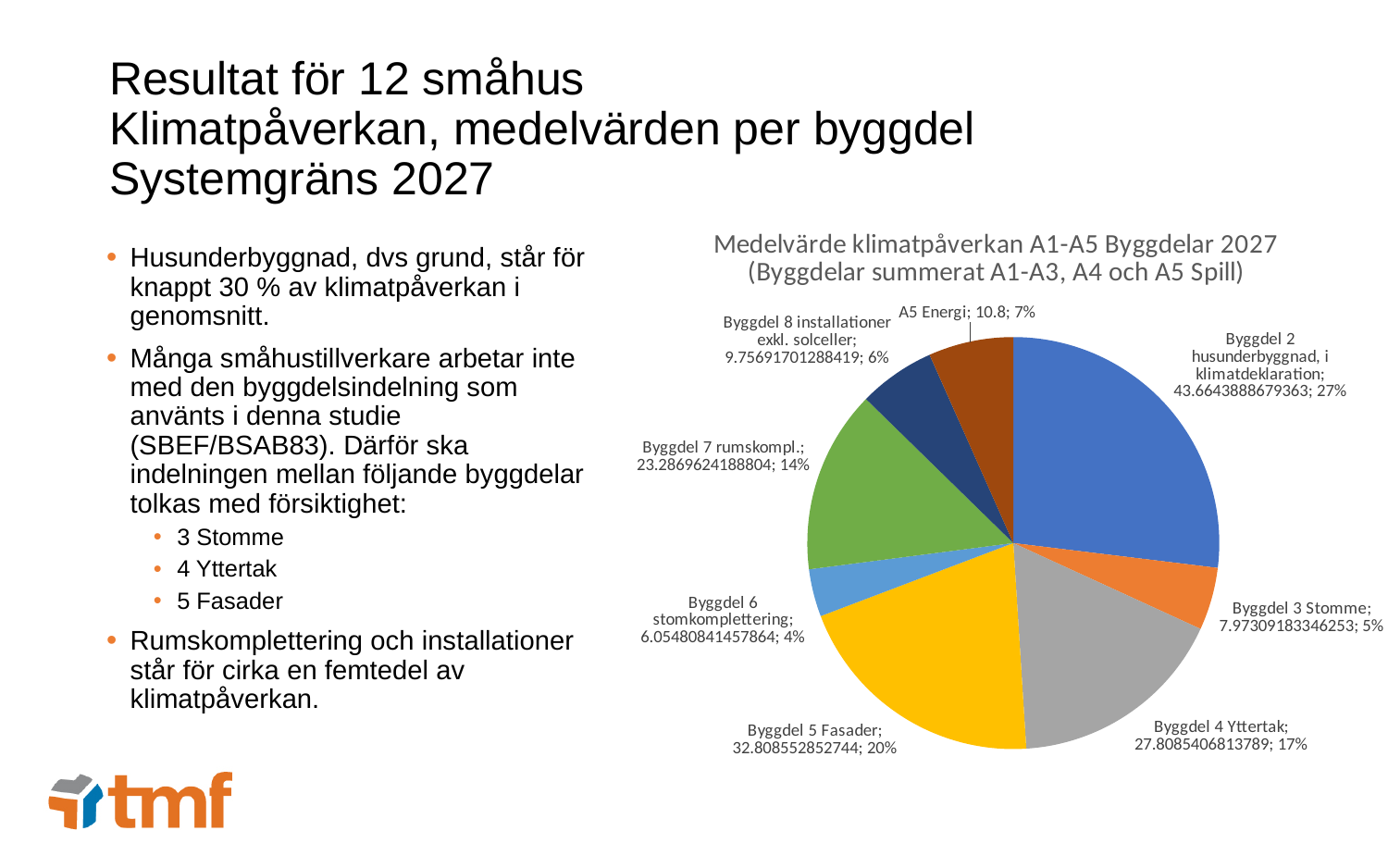
What percentage share does Byggdel 7 rumskompl. have in the pie chart? 14% Which category has the smallest share of the pie chart? Byggdel 6 stomkomplettering How many slices does the pie chart have? 8 Which is larger in the pie chart: Byggdel 3 Stomme or Byggdel 8 installationer exkl. solceller? Byggdel 8 installationer exkl. solceller Which category has the largest share of the pie chart? Byggdel 2 husunderbyggnad, i klimatdeklaration What is the difference in percentage points between the shares of Byggdel 2 husunderbyggnad (27%) and Byggdel 5 Fasader (20%)? 7 percentage points What kind of chart is shown on the slide? Pie chart What value is shown for A5 Energi in the pie chart? 10.8 What is the title of the pie chart? Medelvärde klimatpåverkan A1-A5 Byggdelar 2027 (Byggdelar summerat A1-A3, A4 och A5 Spill) What percentage share does Byggdel 6 stomkomplettering have in the pie chart? 4% What percentage share does Byggdel 4 Yttertak have in the pie chart? 17%